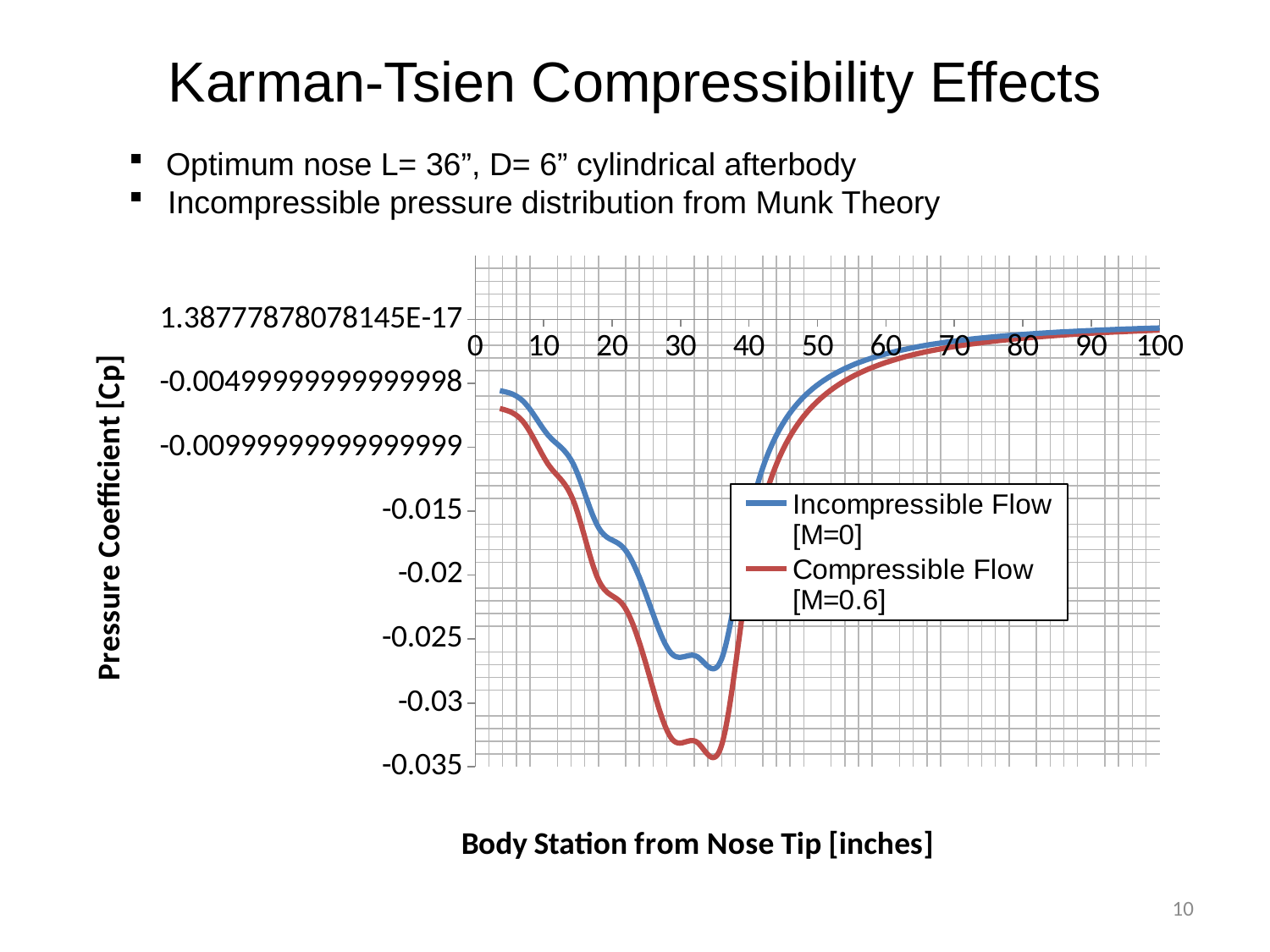
Is the value of the Compressible Flow [M=0.6] series at body station 20 greater or less than -0.02? less What are the two series named in the chart legend? Incompressible Flow [M=0] and Compressible Flow [M=0.6] How many series does the chart legend list? 2 What is the x-axis title of the chart? Body Station from Nose Tip [inches] Which series reaches the lowest pressure coefficient value on the chart? Compressible Flow [M=0.6] Is the minimum value of the Incompressible Flow [M=0] series greater or less than -0.03? greater Is the value of the Incompressible Flow [M=0] series at body station 20 greater or less than -0.02? greater At body station 30, which series has the larger (less negative) pressure coefficient? Incompressible Flow [M=0] Do the values of the Compressible Flow [M=0.6] series rise or fall along the x axis between body station 0 and body station 30? fall Do the values of both series rise or fall along the x axis between body station 40 and body station 100? rise What kind of chart is shown on the slide? line chart